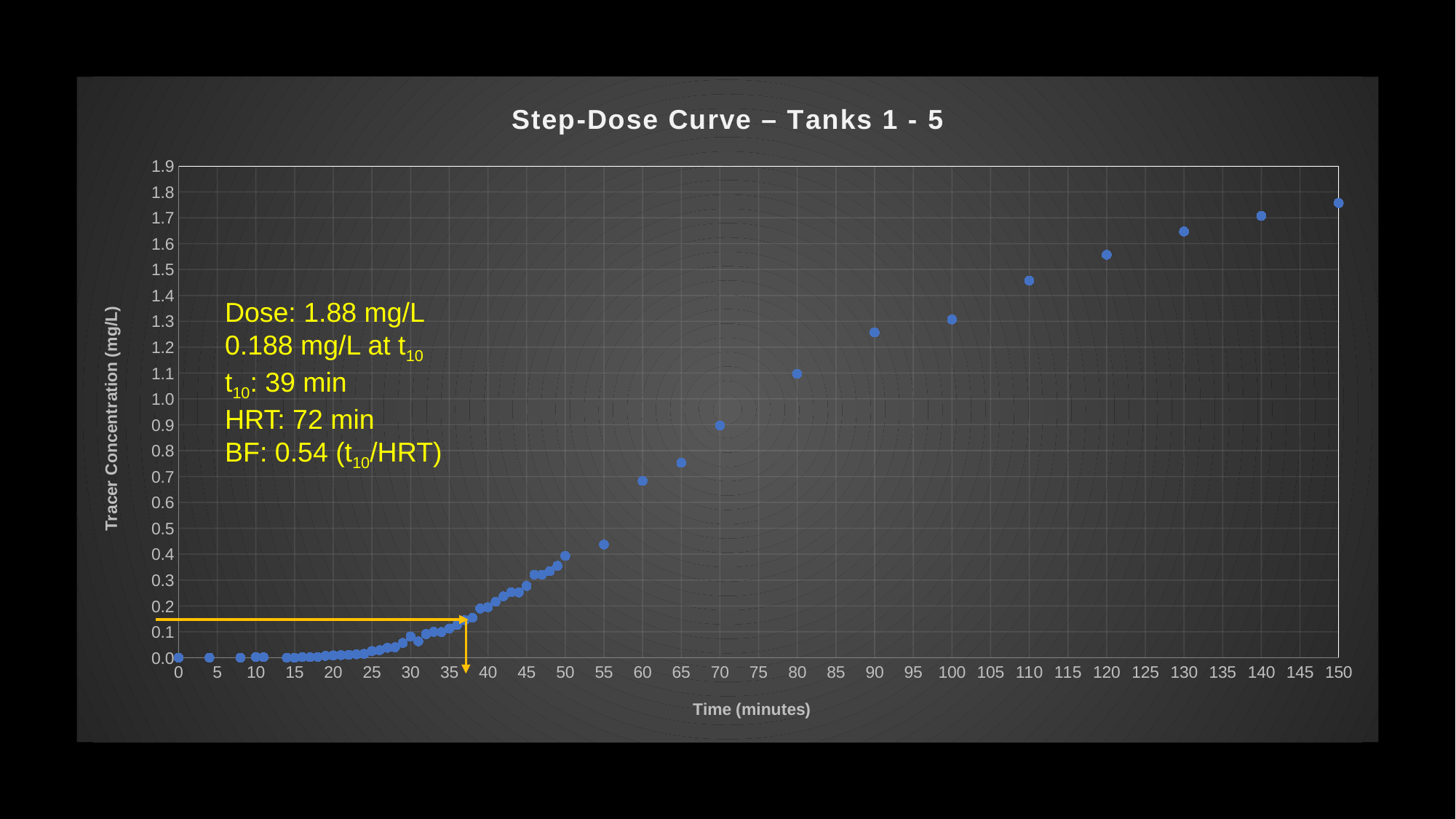
What kind of chart is shown on the slide? Scatter chart What is the title of the chart? Step-Dose Curve – Tanks 1 - 5 Is the tracer concentration at 150 minutes greater or less than 1.7? greater Is the tracer concentration at 110 minutes greater or less than 1.4? greater At which time is the tracer concentration highest? 150 What is the label of the y axis? Tracer Concentration (mg/L) Is the tracer concentration at 65 minutes greater or less than 0.7? greater Do the tracer concentration values rise or fall as time increases along the x axis? Rise Which has the larger tracer concentration, 140 minutes or 150 minutes? 150 minutes Which has the larger tracer concentration, 50 minutes or 55 minutes? 55 minutes